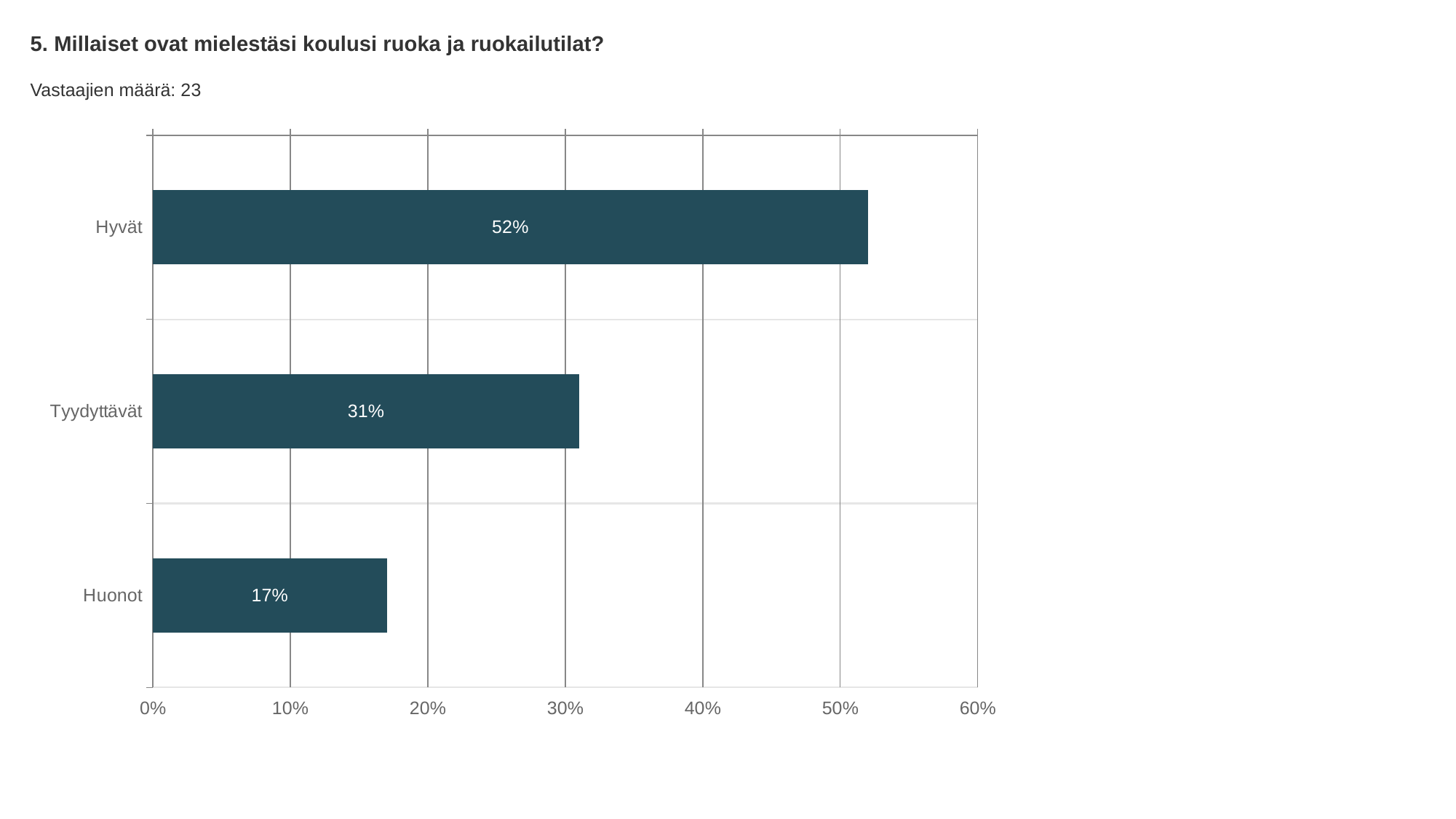
How many categories are shown in the chart? 3 What is the difference between the values for Hyvät and Tyydyttävät? 21% What is the value for Tyydyttävät? 31% What is the value for Hyvät? 52% What is the value for Huonot? 17% How many respondents (Vastaajien määrä) does the slide report? 23 Is the value for Hyvät greater or less than 50%? greater What kind of chart is shown on the slide? bar chart Which category has the lowest value? Huonot Which is larger, the value for Tyydyttävät or the value for Huonot? Tyydyttävät What is the difference between the values for Tyydyttävät and Huonot? 14% Which category has the highest value? Hyvät